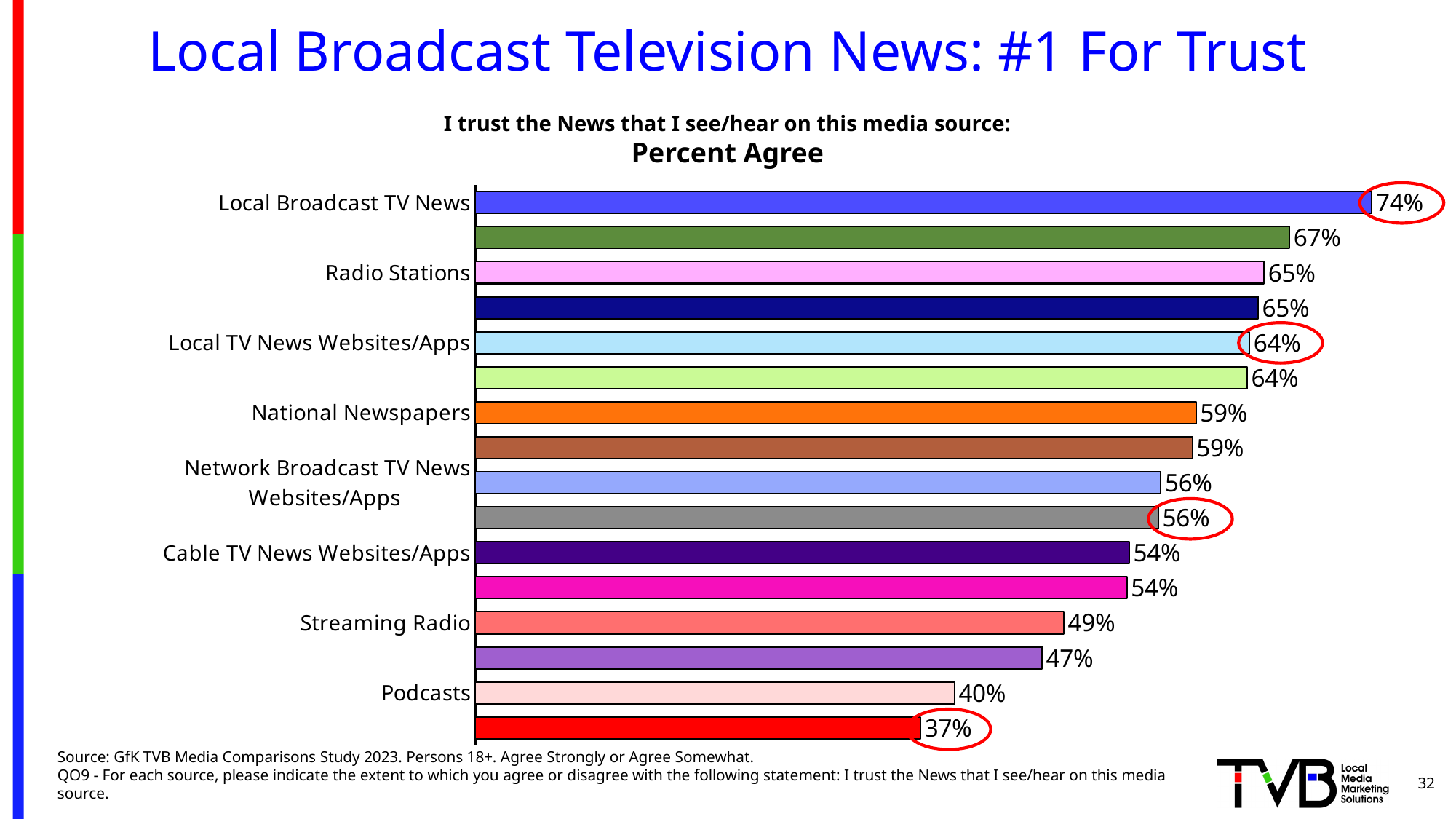
What is the title of the slide? Local Broadcast Television News: #1 For Trust Which media source has the highest percent agree? Local Broadcast TV News What is the lowest percent agree value shown on the chart? 37% Which has a higher percent agree, Streaming Radio or Cable TV News Websites/Apps? Cable TV News Websites/Apps What percent agree is shown for Podcasts? 40% What percent agree is shown for Local Broadcast TV News? 74% What percent agree is shown for Radio Stations? 65% What percent agree is shown for Local TV News Websites/Apps? 64% How many bars are plotted on the chart? 16 What kind of chart is shown on the slide? Bar chart What percent agree is shown for National Newspapers? 59% What is the difference in percent agree between Local Broadcast TV News and Podcasts? 34%